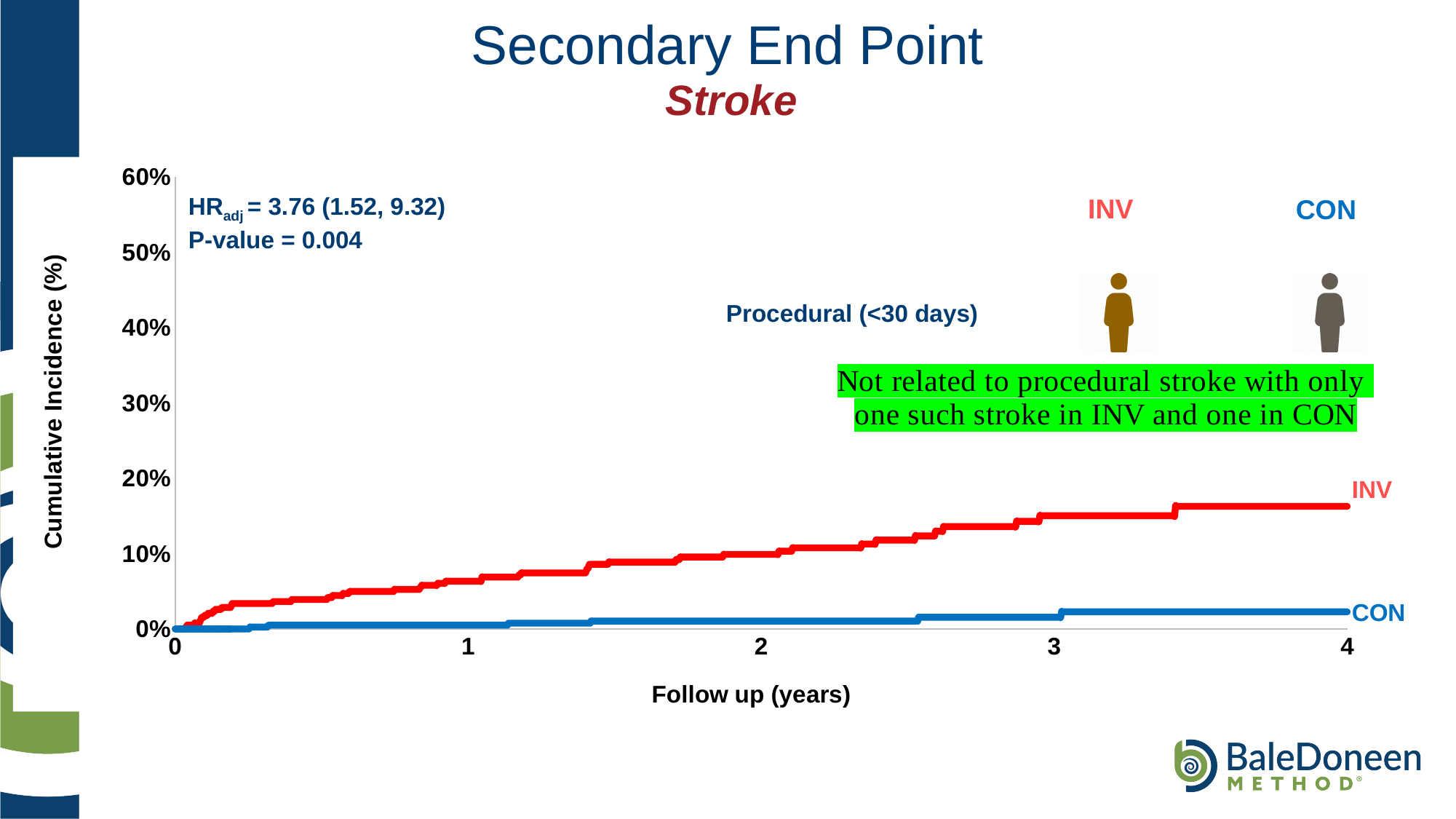
Which series has the higher cumulative incidence at 4 years of follow up, INV or CON? INV Does the cumulative incidence for INV rise or fall as follow up time increases? rise Which series has the lower cumulative incidence at 4 years of follow up? CON What is the adjusted hazard ratio (HR adj) shown on the chart? 3.76 (1.52, 9.32) Is the cumulative incidence for INV at 4 years greater or less than 20%? less What kind of chart is shown on the slide? line chart What is the P-value shown on the chart? 0.004 Is the cumulative incidence for INV at 4 years greater or less than 10%? greater Is the cumulative incidence for INV at 2 years greater or less than 20%? less How many series are plotted on the chart? 2